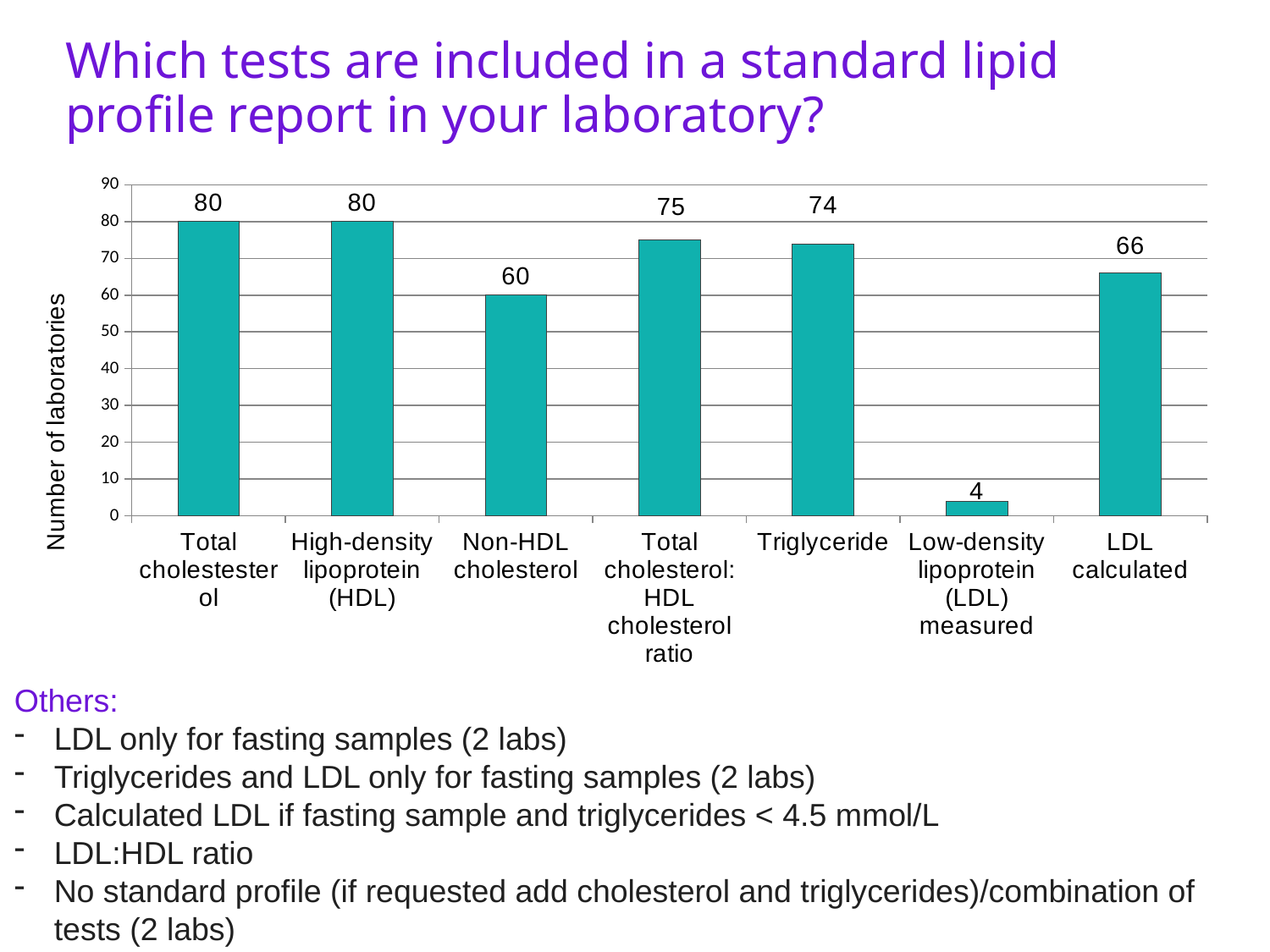
Is the value for Low-density lipoprotein (LDL) measured greater or less than 10? less What is the number of laboratories for Triglyceride? 74 What is the difference in number of laboratories between High-density lipoprotein (HDL) and Non-HDL cholesterol? 20 What is the label of the vertical axis of the chart? Number of laboratories What is the difference in number of laboratories between Total cholesterol:HDL cholesterol ratio and LDL calculated? 9 What type of chart is shown on the slide? bar chart Which has more laboratories, Triglyceride or LDL calculated? Triglyceride What is the number of laboratories for Total cholesterol:HDL cholesterol ratio? 75 What is the number of laboratories for LDL calculated? 66 How many laboratories include Non-HDL cholesterol in their standard lipid profile report? 60 How many test categories are shown in the chart? 7 Which test has the lowest number of laboratories? Low-density lipoprotein (LDL) measured